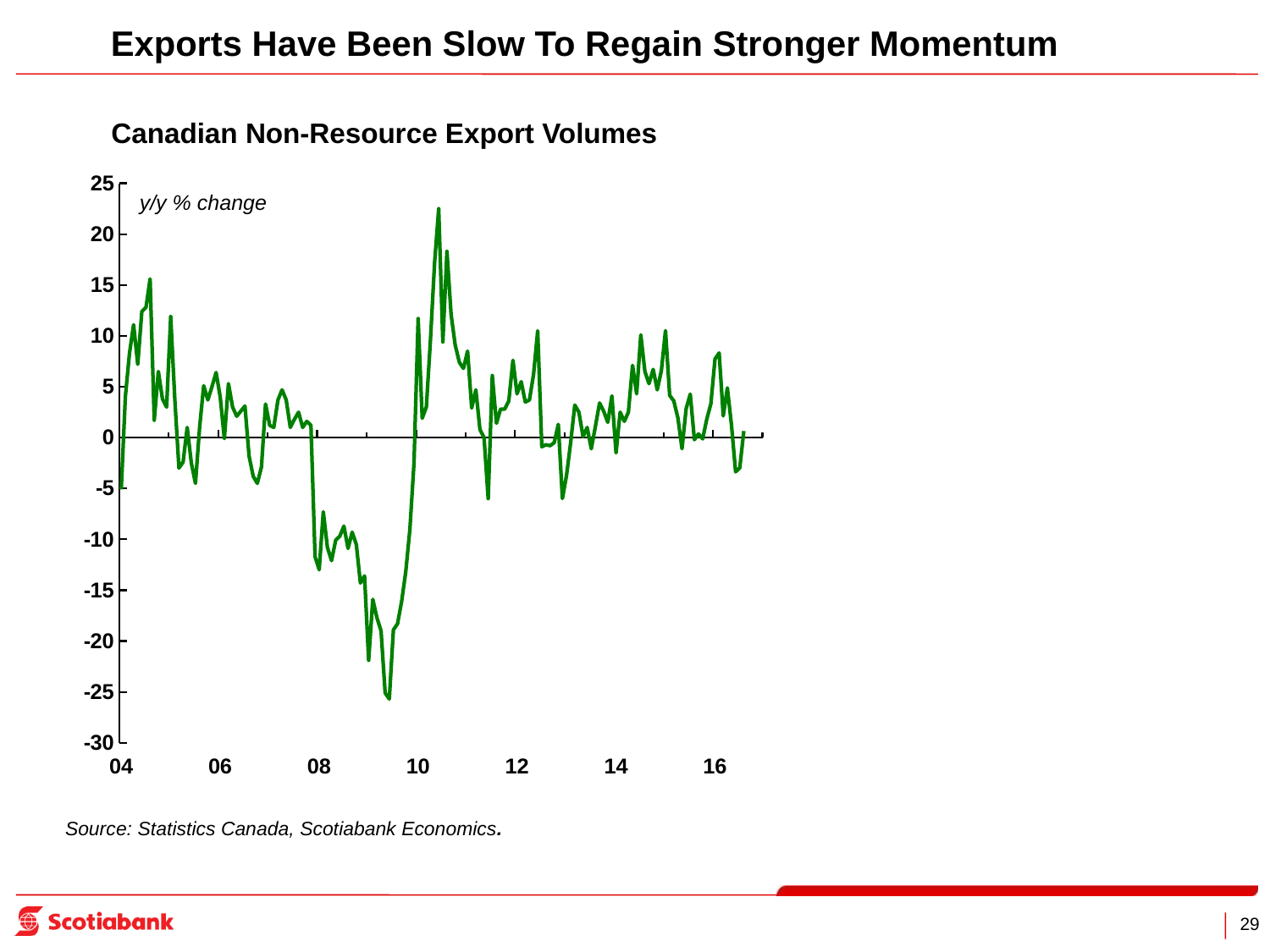
Is the lowest value of the line, reached in 2009, greater or less than -20? less Does the line rise or fall between 2009 and 2010? rise How many year labels are shown on the x axis? 7 In which year does the line reach its highest point? 2010 Is the peak value reached in 2004 greater or less than 10? greater Does the line rise or fall between 2008 and 2009? fall What kind of chart is shown on the slide? line chart In which year does the line reach its lowest point? 2009 Is the value of the line at the start of 2008 greater or less than -5? less What is the title of the chart? Canadian Non-Resource Export Volumes What unit is the y axis of the chart measured in, according to the label inside the plot? y/y % change